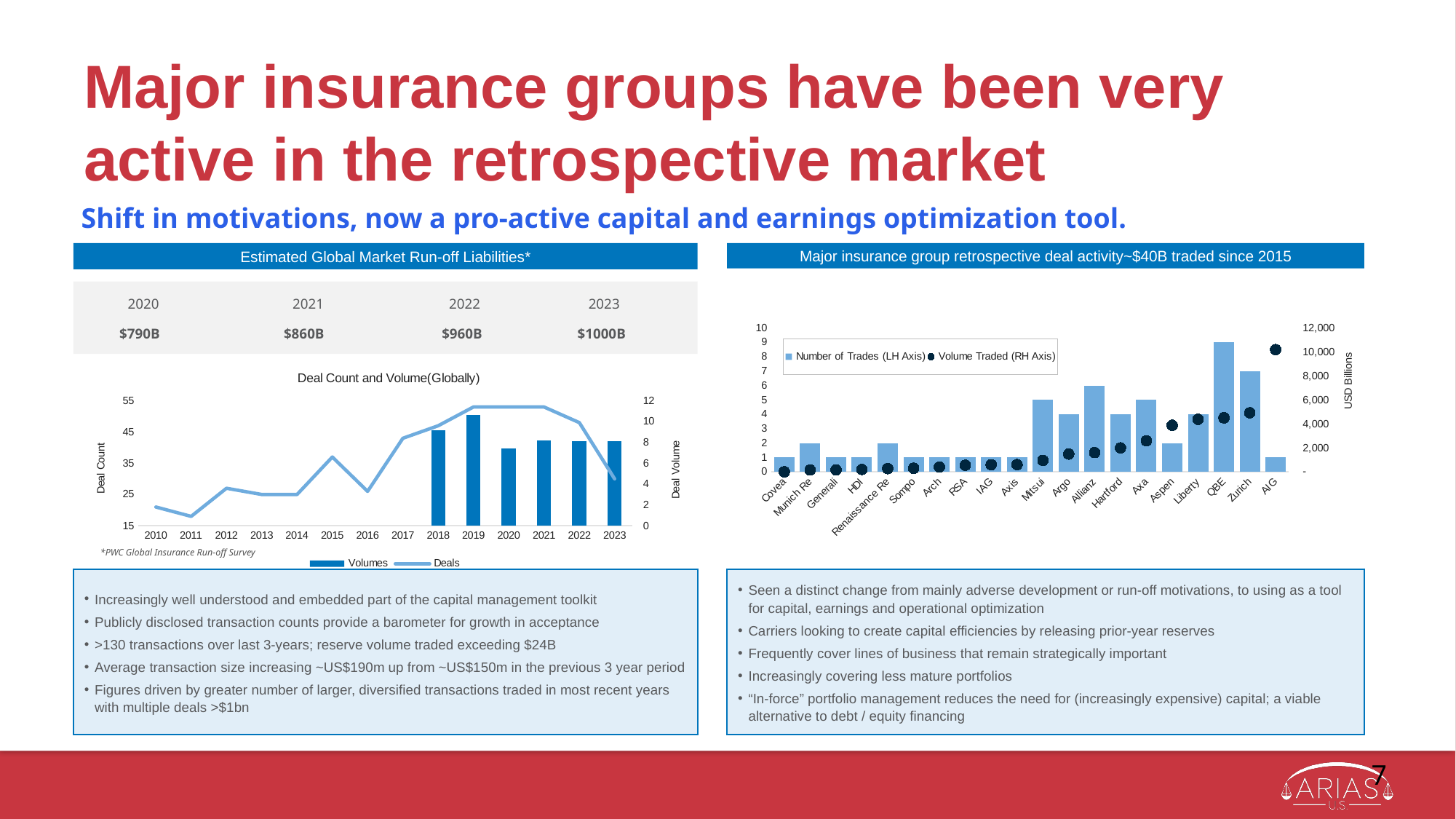
In the 'Deal Count and Volume(Globally)' chart, which year has the tallest Volumes bar? 2019 In the 'Deal Count and Volume(Globally)' chart, does the Deals line rise or fall from 2016 to 2019? rise In the right-hand chart, which has more trades, Mitsui or Argo? Mitsui In the right-hand chart, which insurance group has the highest Volume Traded? AIG In the right-hand chart, is the Volume Traded for AIG greater or less than 8,000? greater How many series does the legend of the right-hand chart list? 2 In the 'Deal Count and Volume(Globally)' chart, is the Deals value for 2011 greater or less than 25? less What kind of chart is the 'Major insurance group retrospective deal activity' chart on the right? bar chart In the right-hand chart, how many trades are shown for QBE? 9 How many insurance groups are listed along the x axis of the right-hand chart? 20 In the right-hand chart, how many trades are shown for Zurich? 7 In the right-hand chart, which insurance group has the highest number of trades? QBE